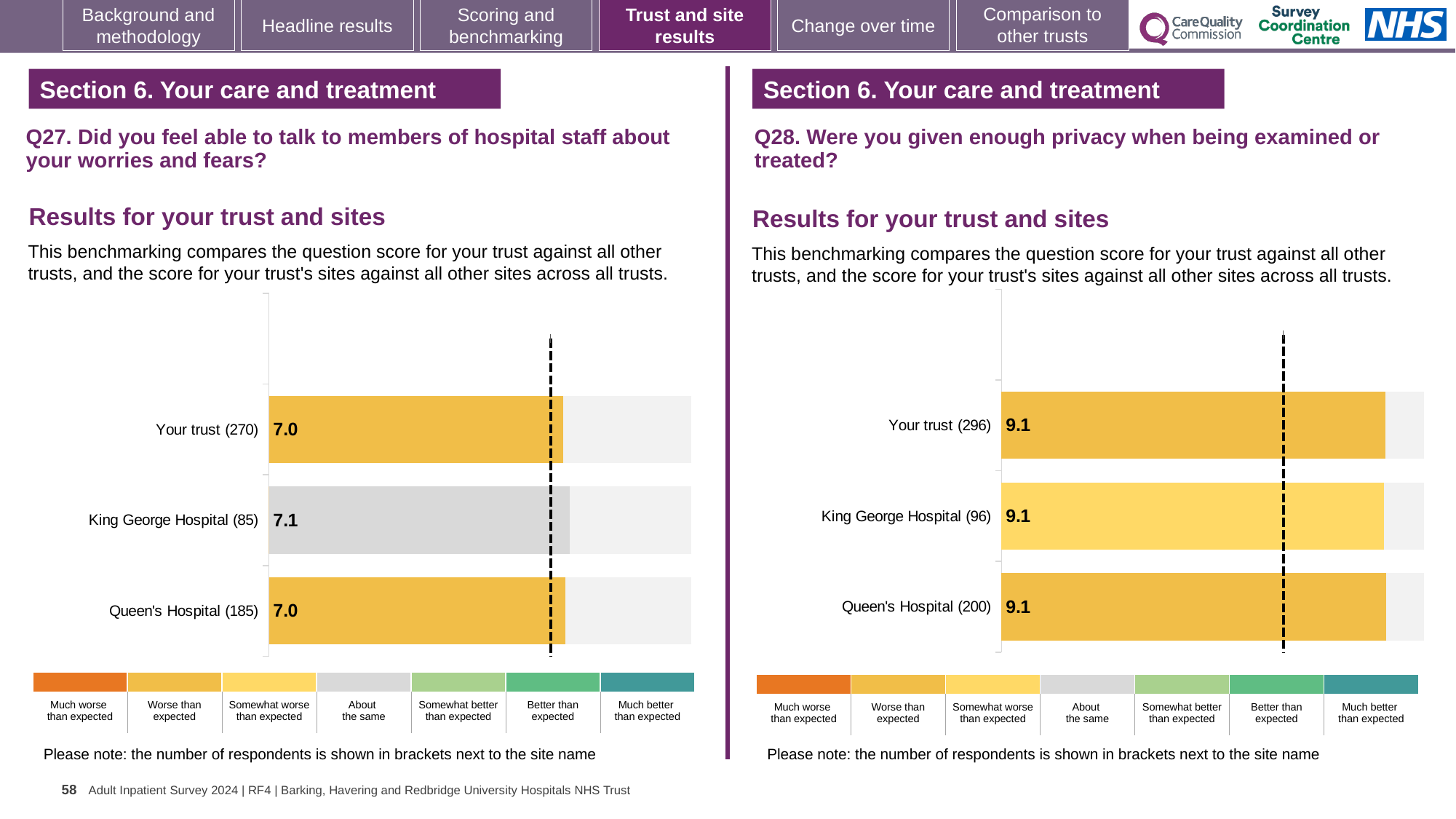
In the Q28 chart on the right, what is the score for Your trust? 9.1 In the Q27 chart on the left, what is the score for King George Hospital? 7.1 What kind of chart is used for the Q28 results on the right? Bar chart In the Q28 chart on the right, how many respondents are shown for King George Hospital? 96 In the Q27 chart on the left, what is the score for Queen's Hospital? 7.0 In the Q27 chart on the left, how many bars are plotted? 3 In the Q27 chart on the left, which site or trust has the highest score? King George Hospital In the Q27 chart on the left, which benchmark category does the grey colour of the King George Hospital bar represent? About the same In the Q27 chart on the left, what is the score for Your trust? 7.0 In the Q27 chart on the left, what is the difference between the scores for King George Hospital and Queen's Hospital? 0.1 In the Q27 chart on the left, how many respondents are shown for Your trust? 270 In the Q28 chart on the right, what is the score for Queen's Hospital? 9.1